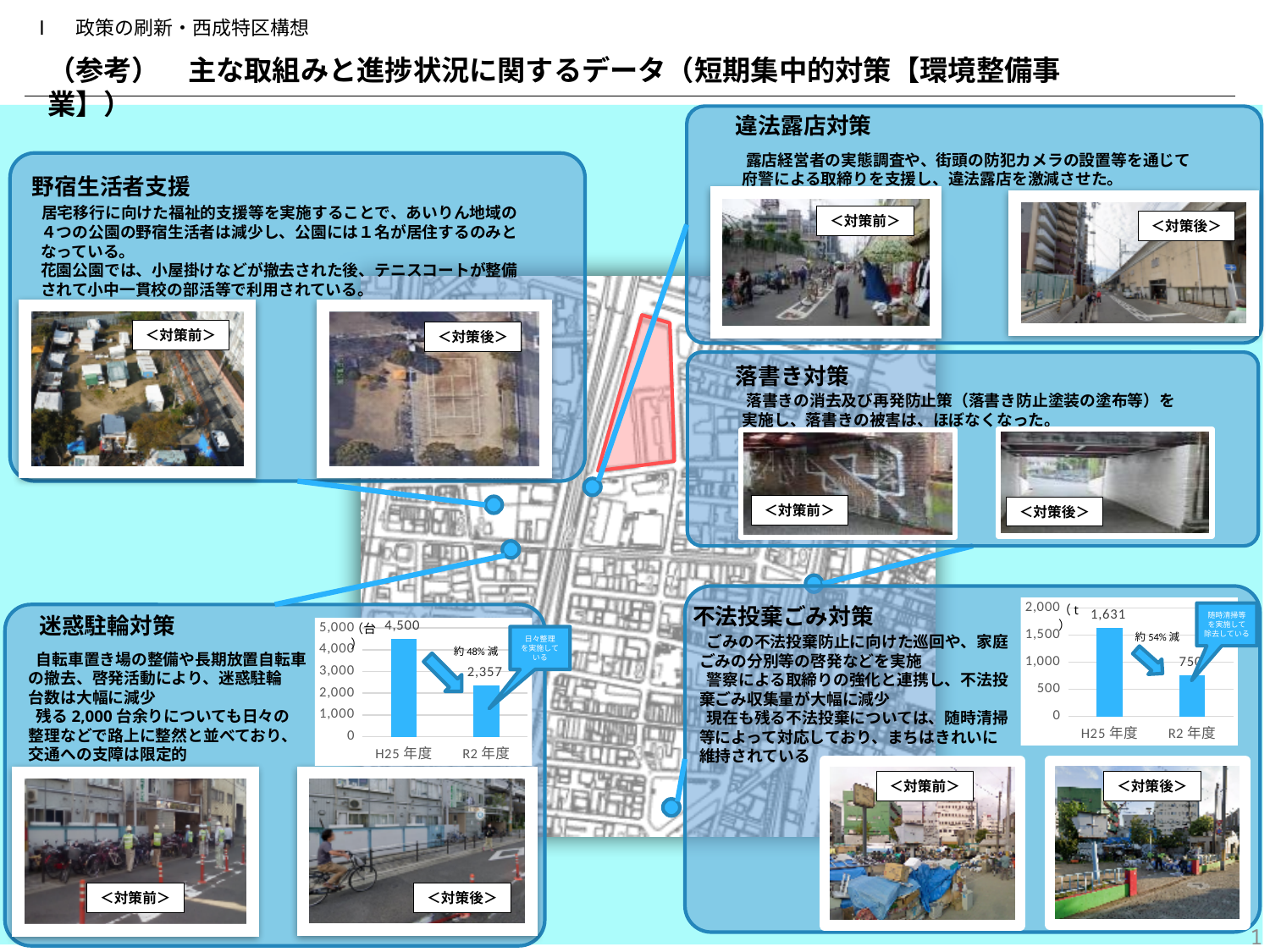
How many categories are shown on the x axis of the bar chart in the 不法投棄ごみ対策 section (bottom right)? 2 In the bar chart in the 不法投棄ごみ対策 section (bottom right), what is the value for H25 年度? 1,631 In the bar chart in the 迷惑駐輪対策 section (bottom left), what is the value for R2 年度? 2,357 In the bar chart in the 迷惑駐輪対策 section (bottom left), what is the difference between the H25 年度 and R2 年度 values? 2,143 In the bar chart in the 迷惑駐輪対策 section (bottom left), what is the value for H25 年度? 4,500 What kind of chart is used in the 迷惑駐輪対策 section (bottom left)? bar chart In the bar chart in the 迷惑駐輪対策 section (bottom left), what percentage reduction is annotated between the two bars? 約48%減 In the bar chart in the 不法投棄ごみ対策 section (bottom right), is the value for R2 年度 greater or less than 1,000? less In the bar chart in the 不法投棄ごみ対策 section (bottom right), what is the value for R2 年度? 750 In the bar chart in the 不法投棄ごみ対策 section (bottom right), what is the difference between the H25 年度 and R2 年度 values? 881 In the bar chart in the 迷惑駐輪対策 section (bottom left), which category has the higher value, H25 年度 or R2 年度? H25 年度 In the bar chart in the 不法投棄ごみ対策 section (bottom right), which category has the lowest value? R2 年度